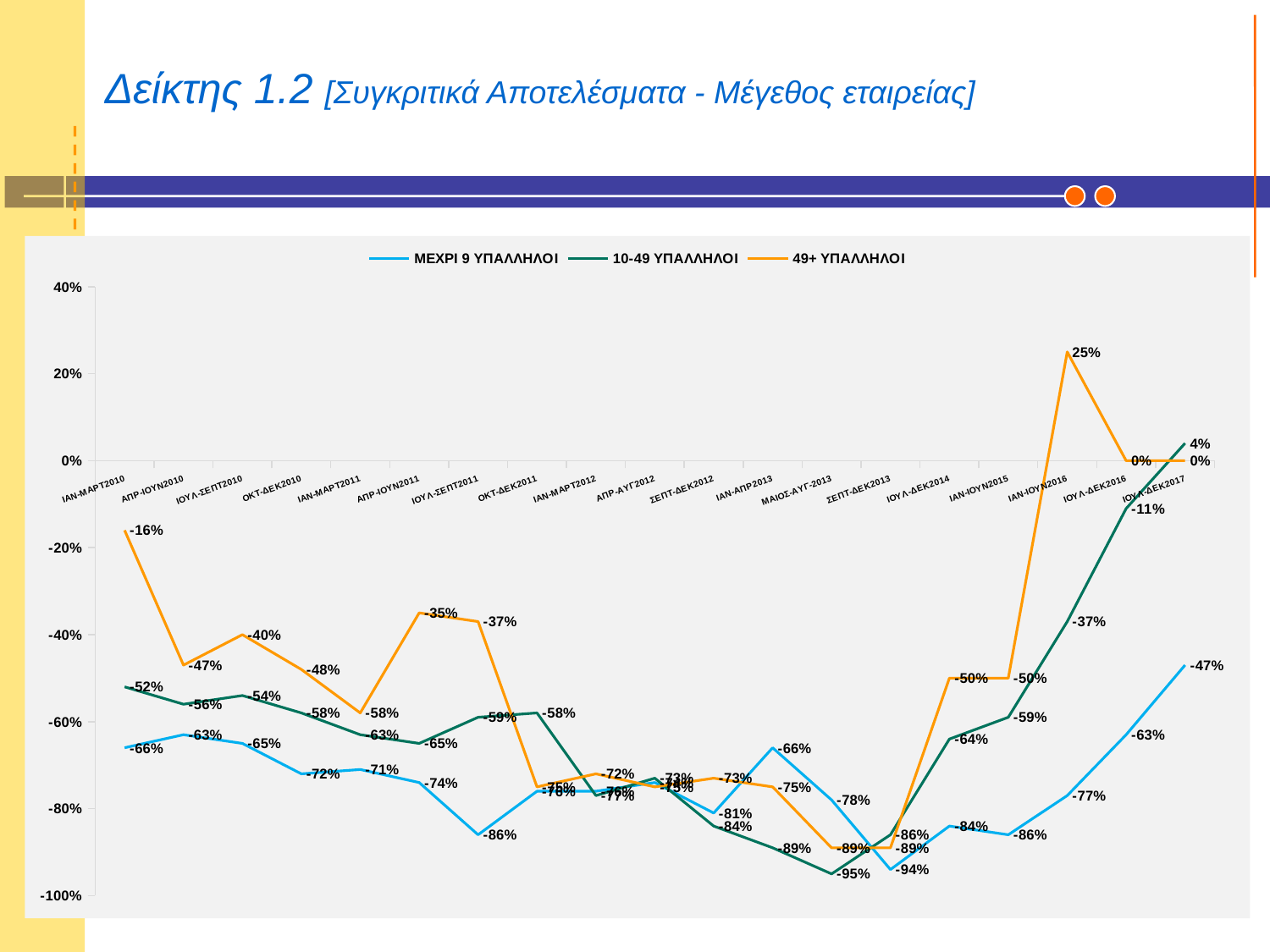
What is the value for 49+ ΥΠΑΛΛΗΛΟΙ in ΙΑΝ-ΙΟΥΝ2016? 25% In ΙΑΝ-ΙΟΥΝ2016, what is the difference between the 49+ ΥΠΑΛΛΗΛΟΙ value (25%) and the 10-49 ΥΠΑΛΛΗΛΟΙ value (-37%)? 62 percentage points How many time periods are plotted along the x axis? 19 What kind of chart is shown on the slide? Line chart What is the value for 10-49 ΥΠΑΛΛΗΛΟΙ in ΙΟΥΛ-ΔΕΚ2017? 4% What is the value for 49+ ΥΠΑΛΛΗΛΟΙ in ΙΑΝ-ΜΑΡΤ2010? -16% What is the value for 10-49 ΥΠΑΛΛΗΛΟΙ in ΙΟΥΛ-ΔΕΚ2016? -11% In which period does the 49+ ΥΠΑΛΛΗΛΟΙ series reach its highest value? ΙΑΝ-ΙΟΥΝ2016 What is the value for ΜΕΧΡΙ 9 ΥΠΑΛΛΗΛΟΙ in ΙΟΥΛ-ΔΕΚ2017? -47% How many series does the legend list? 3 What is the lowest value of the 10-49 ΥΠΑΛΛΗΛΟΙ series? -95% In ΙΑΝ-ΜΑΡΤ2010, which series has the higher value: 49+ ΥΠΑΛΛΗΛΟΙ or ΜΕΧΡΙ 9 ΥΠΑΛΛΗΛΟΙ? 49+ ΥΠΑΛΛΗΛΟΙ